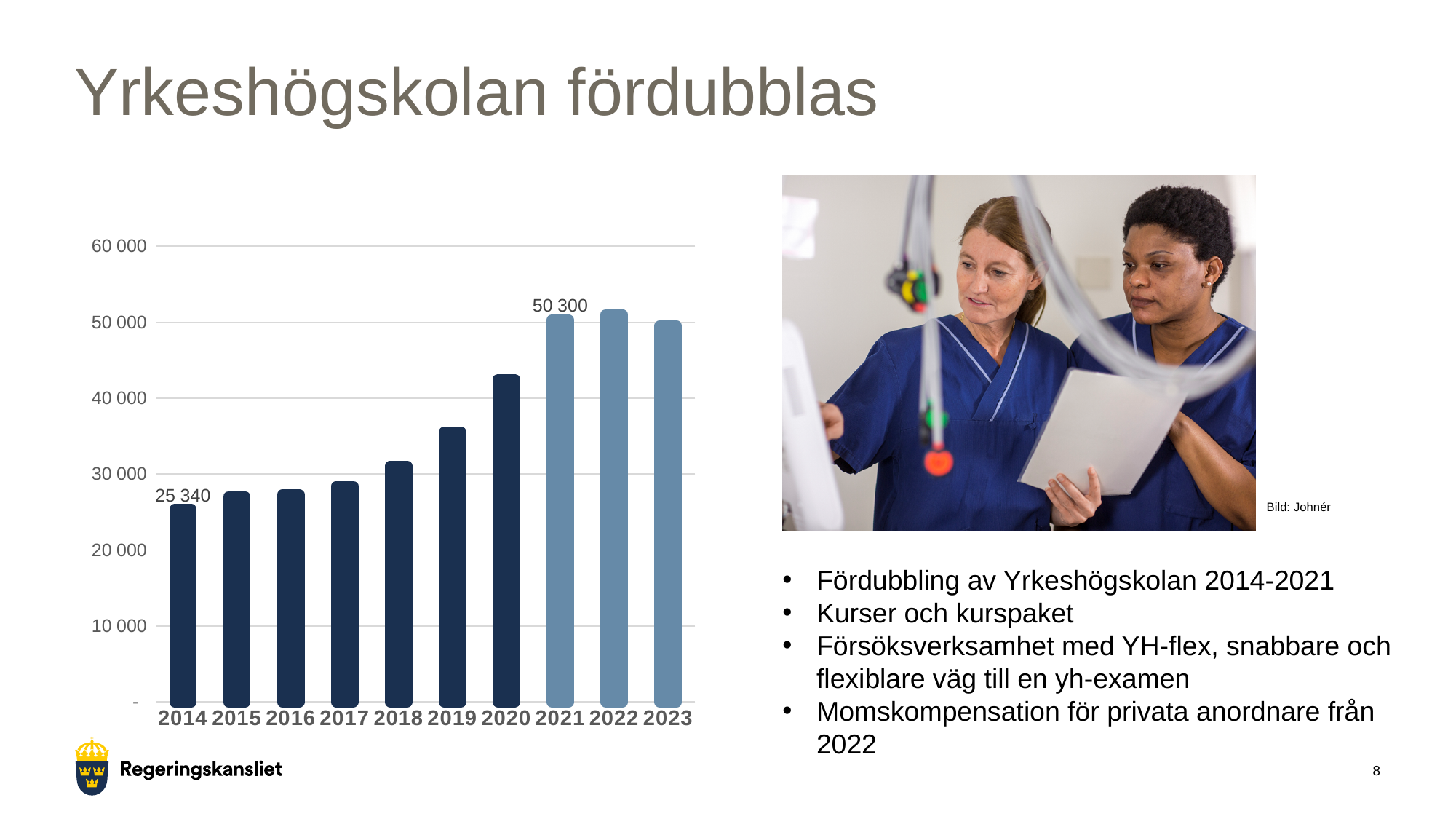
Is the value for 2019 greater or less than 40 000? less What is the difference between the values for 2021 and 2014? 24 960 Which years are drawn in a lighter blue colour than the rest? 2021, 2022 and 2023 Is the value for 2020 greater or less than 40 000? greater Do the values generally rise or fall from 2014 to 2021? rise Is the value for 2017 greater or less than 30 000? less How many years are shown on the x axis? 10 Which is larger, the value for 2021 or the value for 2014? 2021 What is the value shown for 2021? 50 300 What is the value shown for 2014? 25 340 Which year has the lowest bar? 2014 What kind of chart is shown on the slide? bar chart